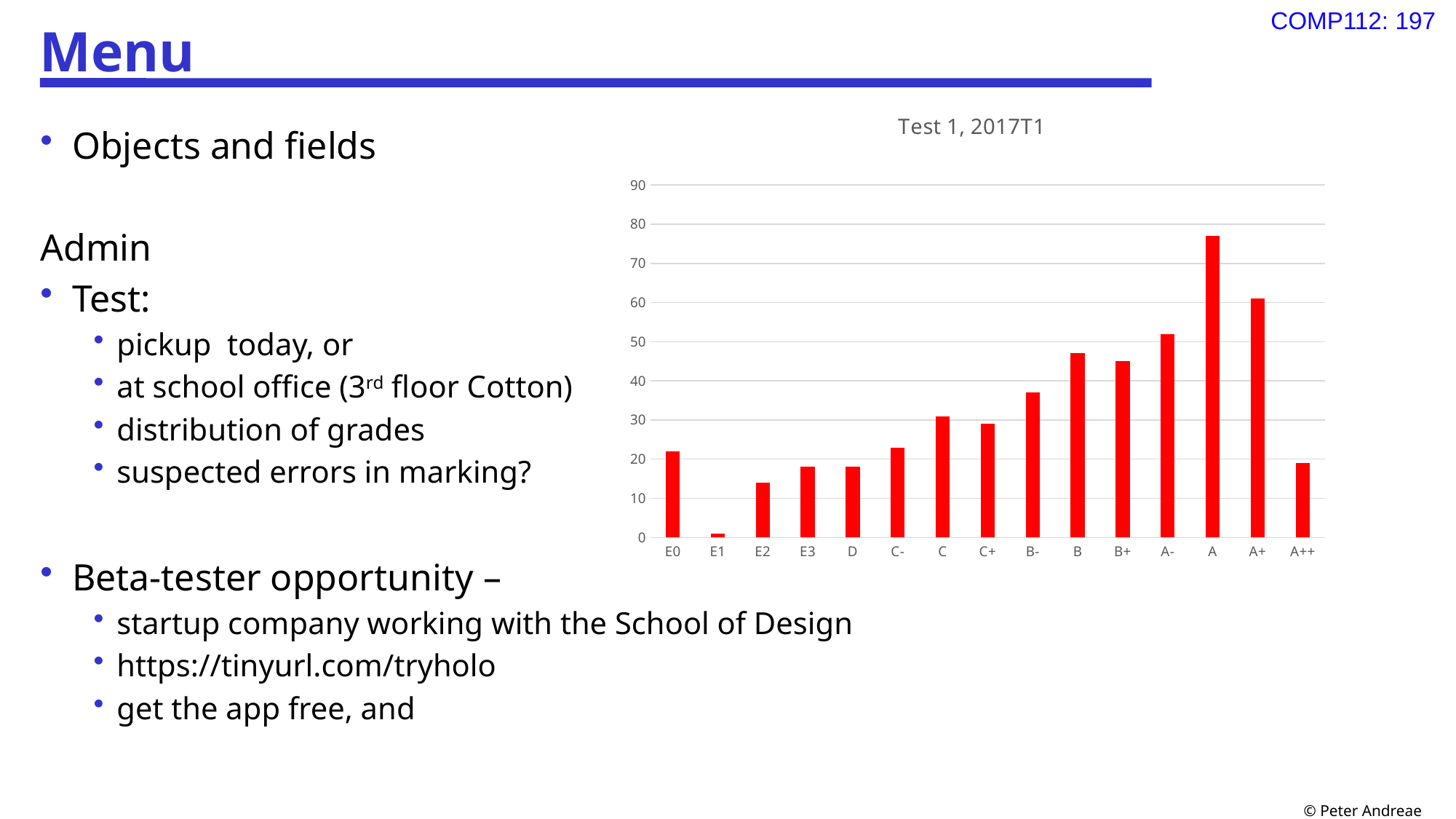
Is the value for A greater or less than 70? greater Which grade category has the highest bar in the chart? A Is the value for B- greater or less than 40? less Is the value for A+ greater or less than 50? greater What kind of chart is shown on the slide? bar chart Which has the larger value, B or B-? B What is the title of the chart? Test 1, 2017T1 How many grade categories are shown on the x axis of the chart? 15 Which has the larger value, A or A+? A Which grade category has the lowest bar in the chart? E1 What colour are the bars in the chart? red